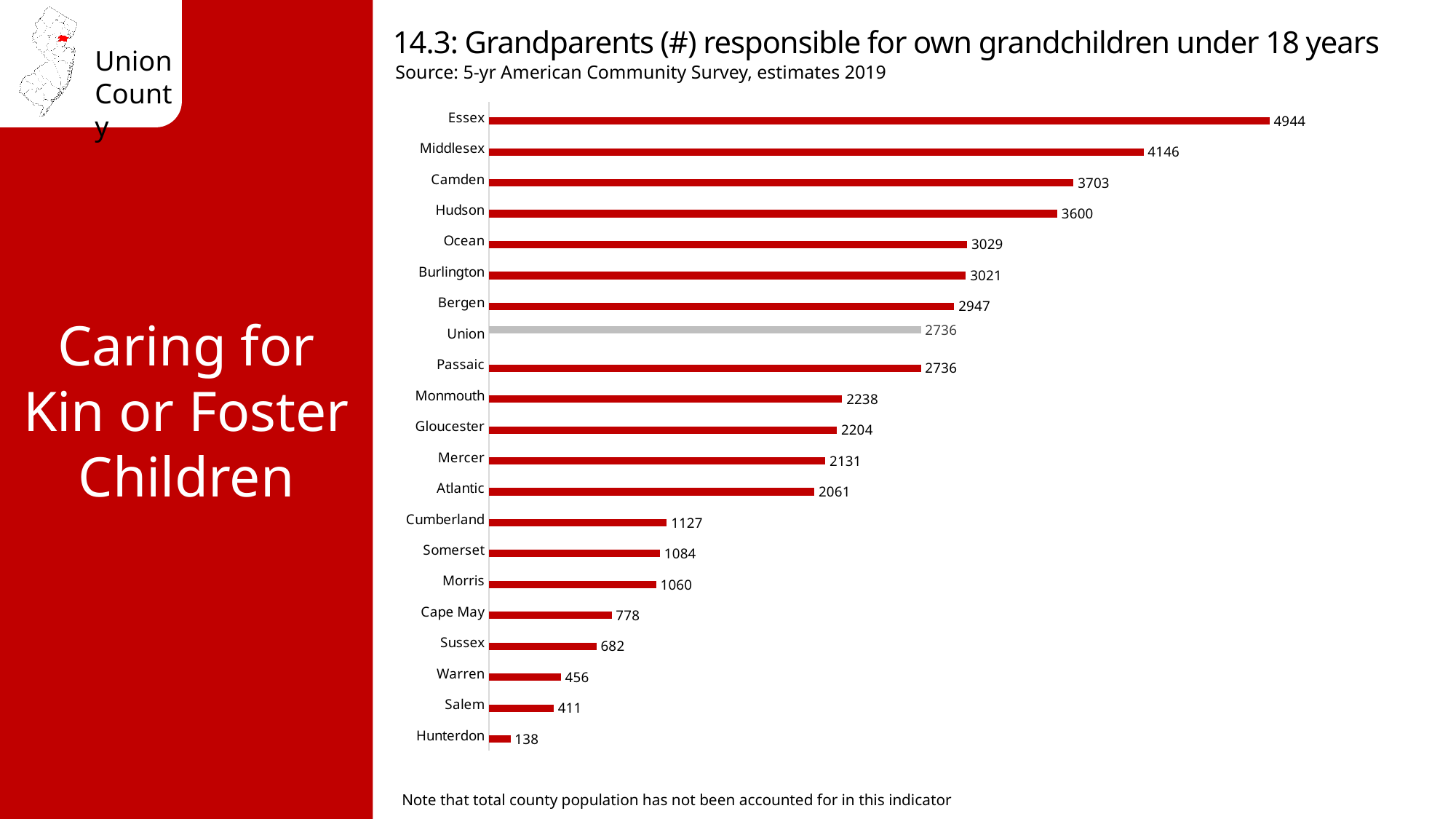
Which is larger, the value for Camden or the value for Hudson? Camden What is the value for Union? 2736 What is the difference between the values for Essex and Middlesex? 798 What is the value for Essex? 4944 Which county's bar is coloured grey instead of red? Union What is the value for Hunterdon? 138 Which county has the lowest value? Hunterdon What is the source of the data shown in the chart? 5-yr American Community Survey, estimates 2019 How many counties are shown in the chart? 21 Which county has the highest number of grandparents responsible for own grandchildren? Essex What kind of chart is shown on the slide? Bar chart What is the difference between the values for Cumberland and Somerset? 43